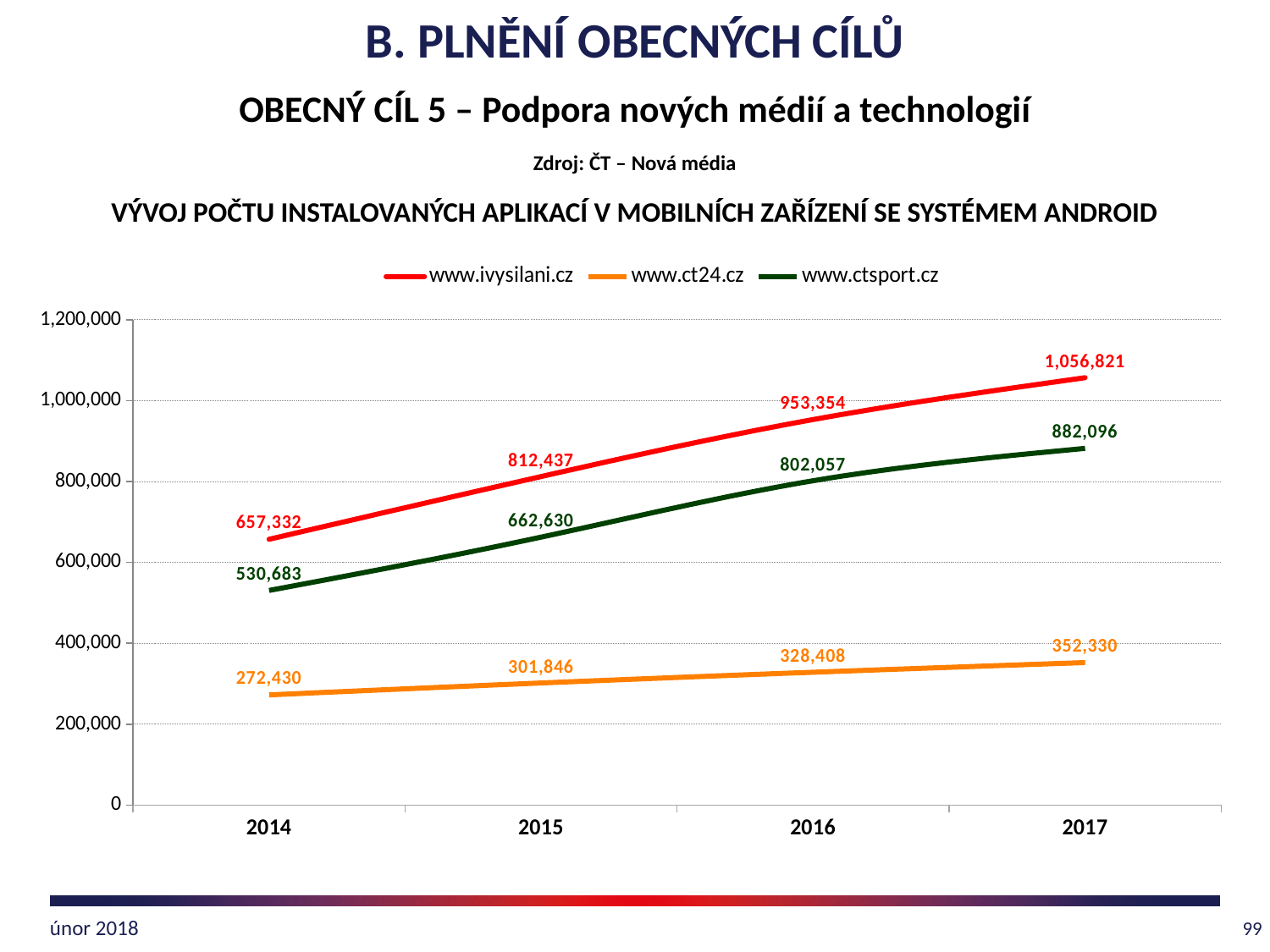
What is the value for www.ct24.cz in 2014? 272,430 What is the value for www.ctsport.cz in 2016? 802,057 What kind of chart is shown? line chart Which series has the lowest value in 2015? www.ct24.cz How many years are shown on the x axis? 4 What is the value for www.ivysilani.cz in 2017? 1,056,821 Which series has the highest value in 2017? www.ivysilani.cz What is the difference between www.ivysilani.cz and www.ctsport.cz in 2017? 174,725 Is the value for www.ivysilani.cz in 2016 greater or less than 1,000,000? less Which is larger in 2016: www.ctsport.cz or www.ct24.cz? www.ctsport.cz Does the value for www.ct24.cz rise or fall from 2014 to 2017? rise How many series does the legend list? 3